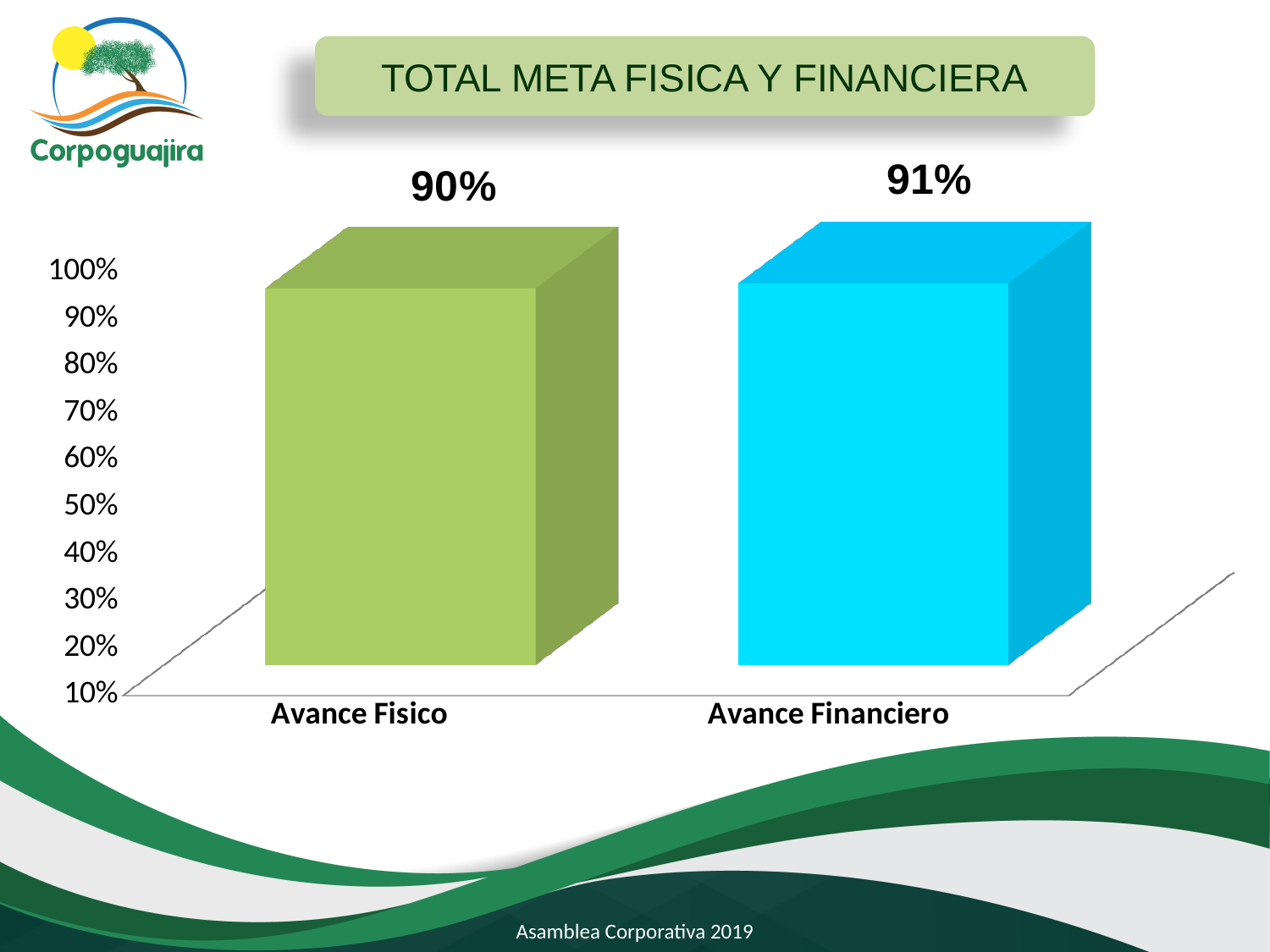
What is the value for Avance Financiero? 91% How many categories are shown in the chart? 2 Is the value for Avance Fisico greater or less than 50%? greater Which category has the lowest value? Avance Fisico What is the value for Avance Fisico? 90% What is the title of the chart? TOTAL META FISICA Y FINANCIERA What kind of chart is shown on the slide? Bar chart Which category has the higher value, Avance Fisico or Avance Financiero? Avance Financiero What is the difference between the values for Avance Financiero and Avance Fisico? 1% Is the value for Avance Financiero greater or less than 80%? greater What colour is the bar for Avance Financiero? Blue